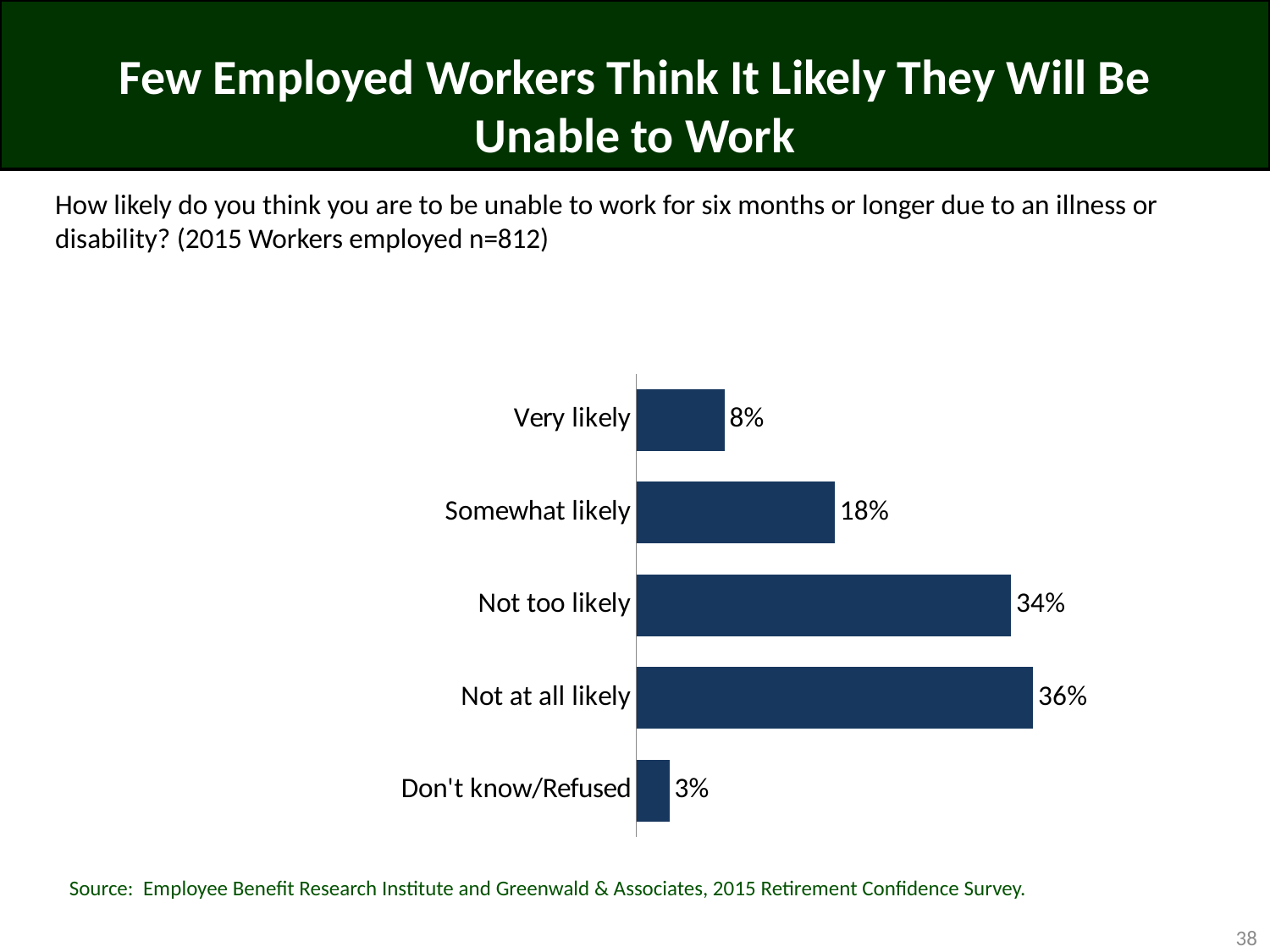
What is the combined percentage of workers who answered 'Very likely' or 'Somewhat likely'? 26% What percentage of employed workers said they are very likely to be unable to work for six months or longer? 8% How many response categories are shown in the chart? 5 What percentage of employed workers answered 'Somewhat likely'? 18% What is the difference in percentage points between 'Not too likely' and 'Somewhat likely'? 16 What percentage of employed workers answered 'Not too likely'? 34% Which response category has the lowest percentage? Don't know/Refused What percentage of employed workers answered 'Don't know/Refused'? 3% Which is larger, the percentage for 'Somewhat likely' or for 'Very likely'? Somewhat likely What type of chart is shown on the slide? Bar chart What is the difference in percentage points between 'Not at all likely' and 'Very likely'? 28 Which response category has the highest percentage? Not at all likely